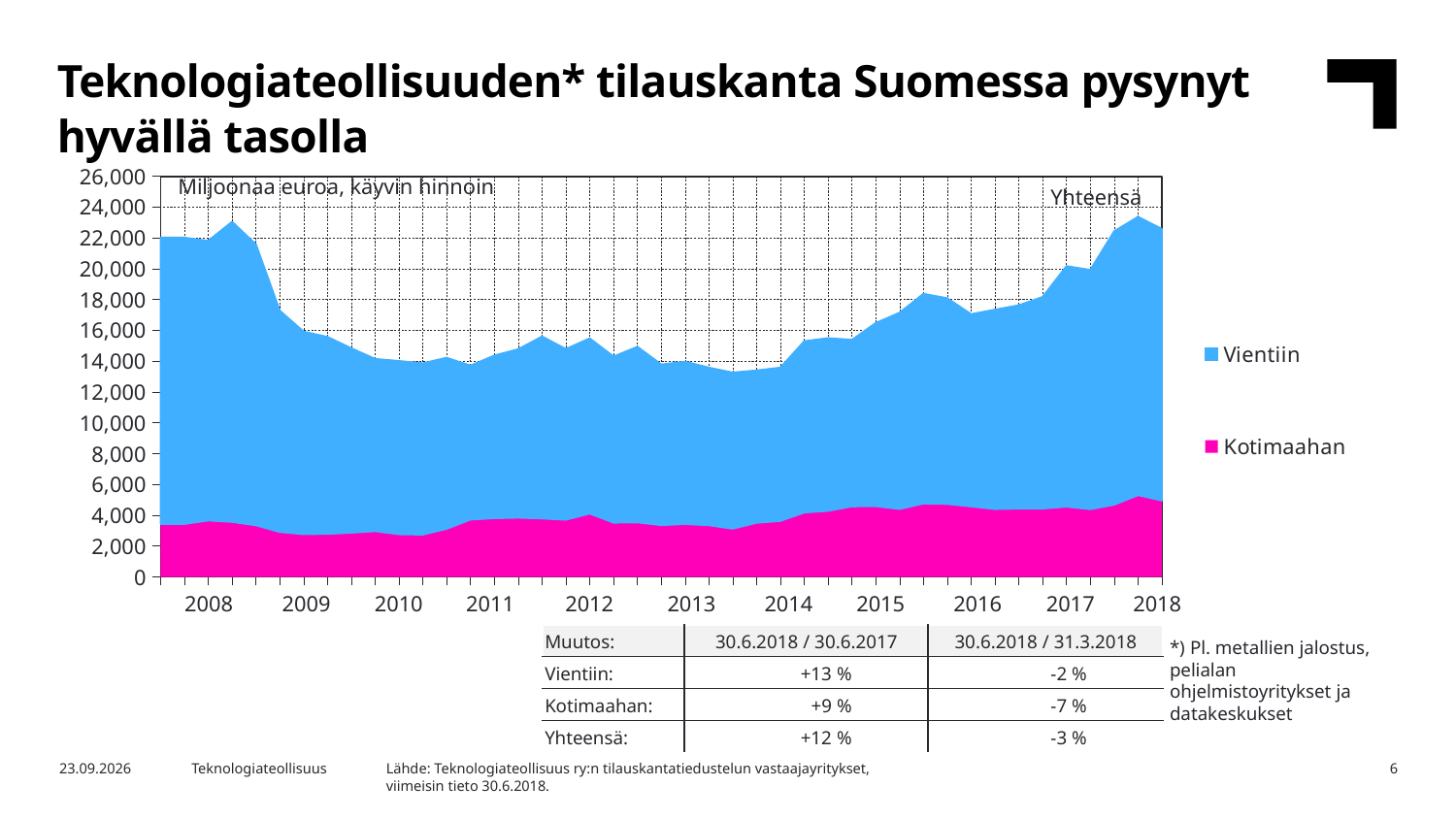
What are the two series named in the chart legend? Vientiin and Kotimaahan What unit label is printed inside the chart area? Miljoonaa euroa, käyvin hinnoin What kind of chart is shown on the slide? Stacked area chart How many series does the chart legend list? 2 Does the total order book (Yhteensä) rise or fall between 2016 and 2018? rise Does the total order book (Yhteensä) rise or fall between 2008 and 2009? fall Is the Kotimaahan value in 2010 greater or less than 4,000? less How many year labels are shown on the x axis? 11 According to the table below the chart, what is the change for Vientiin between 30.6.2017 and 30.6.2018? +13 % Is the total (Yhteensä) value at the start of 2018 greater or less than 20,000? greater Is the total (Yhteensä) value in 2013 greater or less than 16,000? less Which is larger, the total (Yhteensä) value in 2008 or in 2013? 2008